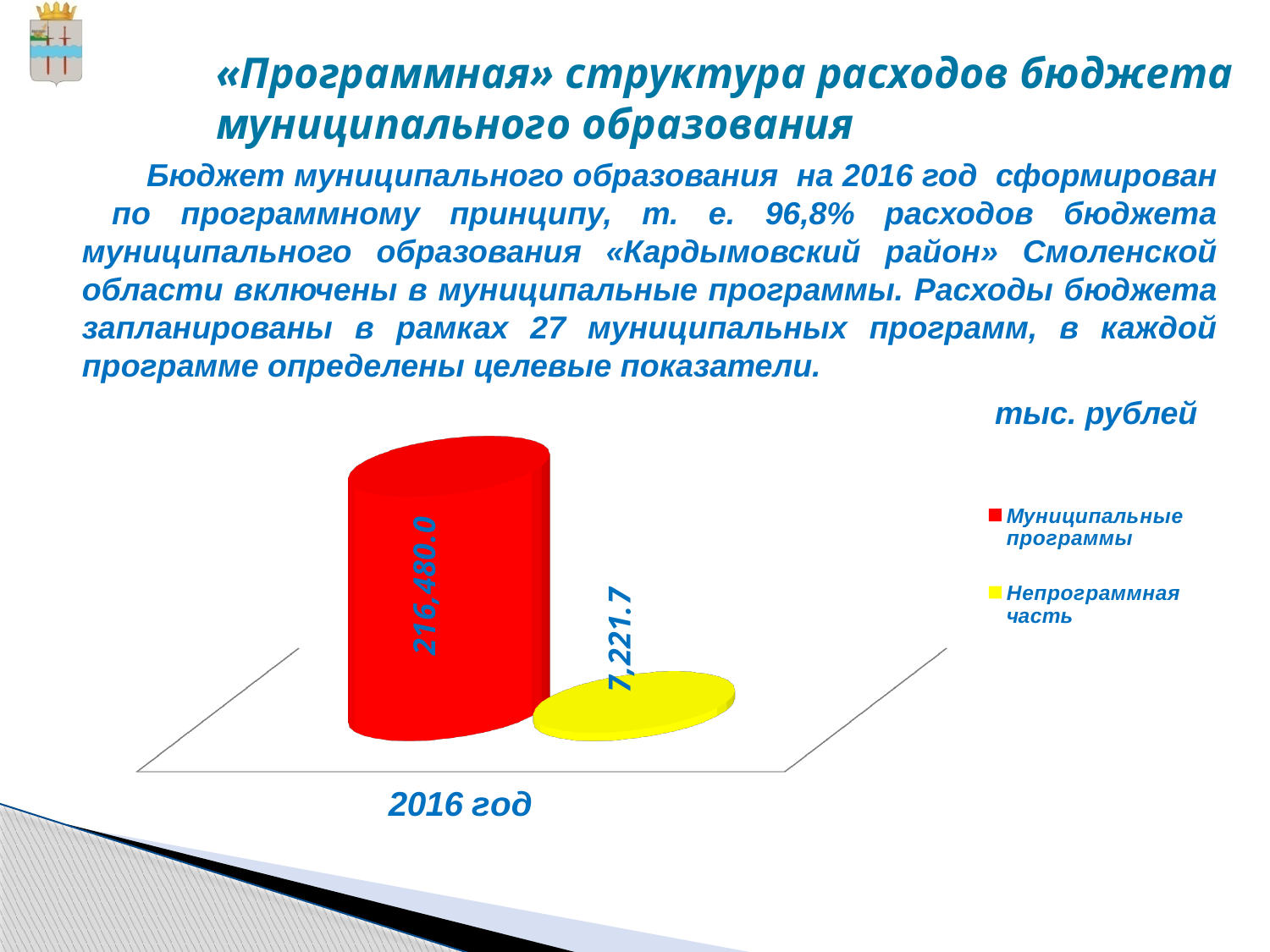
How many categories are shown on the x axis of the chart? 1 How many series does the legend list? 2 Which series has the higher value in 2016 год? Муниципальные программы What is the value for Муниципальные программы in 2016 год? 216,480.0 What is the difference between the values for Муниципальные программы and Непрограммная часть in 2016 год? 209,258.3 What is the value for Непрограммная часть in 2016 год? 7,221.7 Is the value for Муниципальные программы larger or smaller than the value for Непрограммная часть? larger What unit is indicated above the chart? тыс. рублей What kind of chart is shown on the slide? bar chart Which series has the lower value in 2016 год? Непрограммная часть What is the category label shown on the x axis of the chart? 2016 год